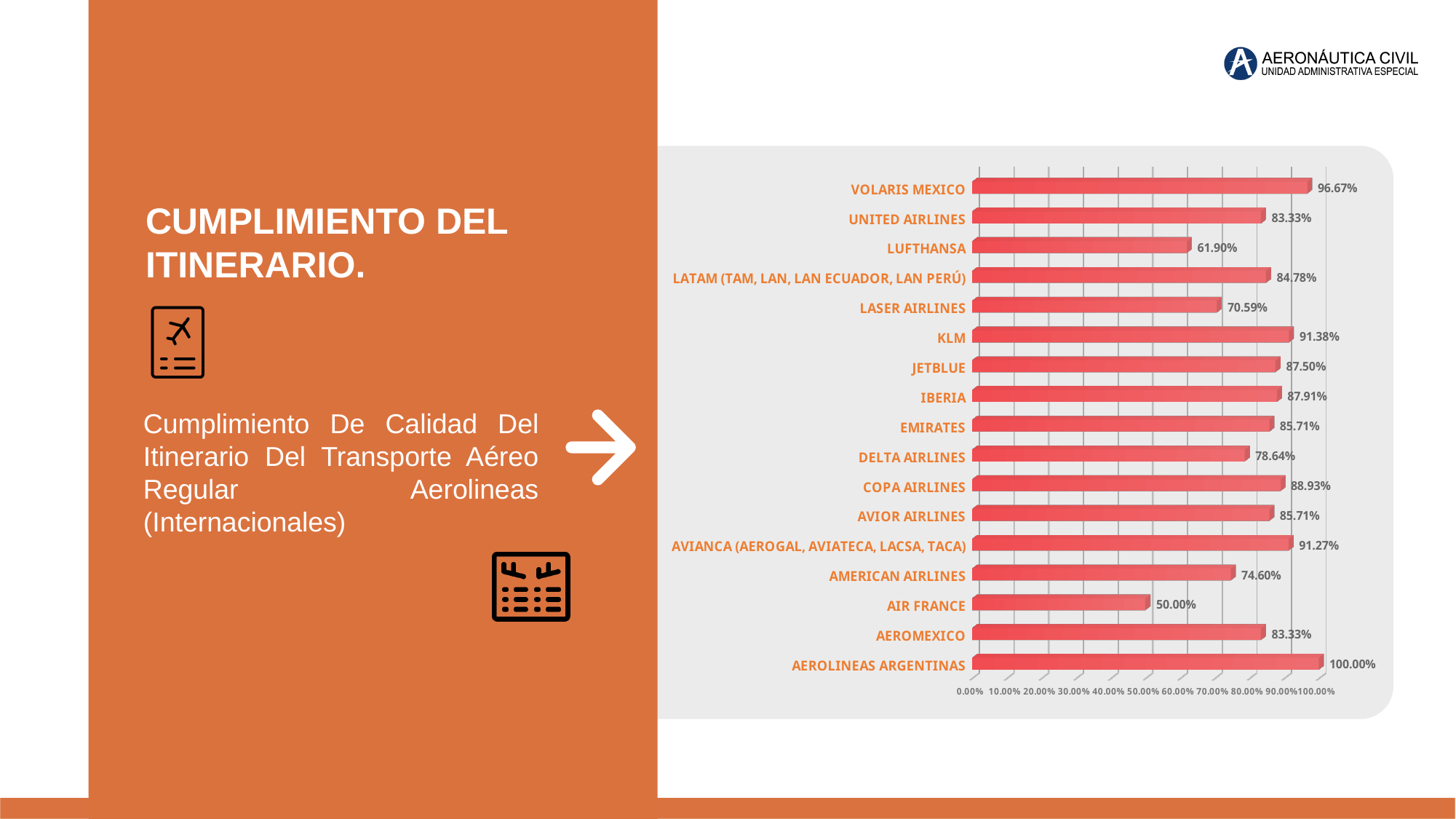
Which is larger, the value for LASER AIRLINES or the value for LUFTHANSA? LASER AIRLINES Which airline has the highest value? AEROLINEAS ARGENTINAS What is the value for AEROMEXICO? 83.33% Which airline has the lowest value? AIR FRANCE How many airlines are shown in the chart? 17 What is the value for VOLARIS MEXICO? 96.67% What is the difference between the values for VOLARIS MEXICO and UNITED AIRLINES? 13.34% What kind of chart is shown on the slide? bar chart What is the value for COPA AIRLINES? 88.93% What is the value for LUFTHANSA? 61.90% Is the value for DELTA AIRLINES greater or less than 80.00%? less What is the difference between the values for LUFTHANSA and AIR FRANCE? 11.90%